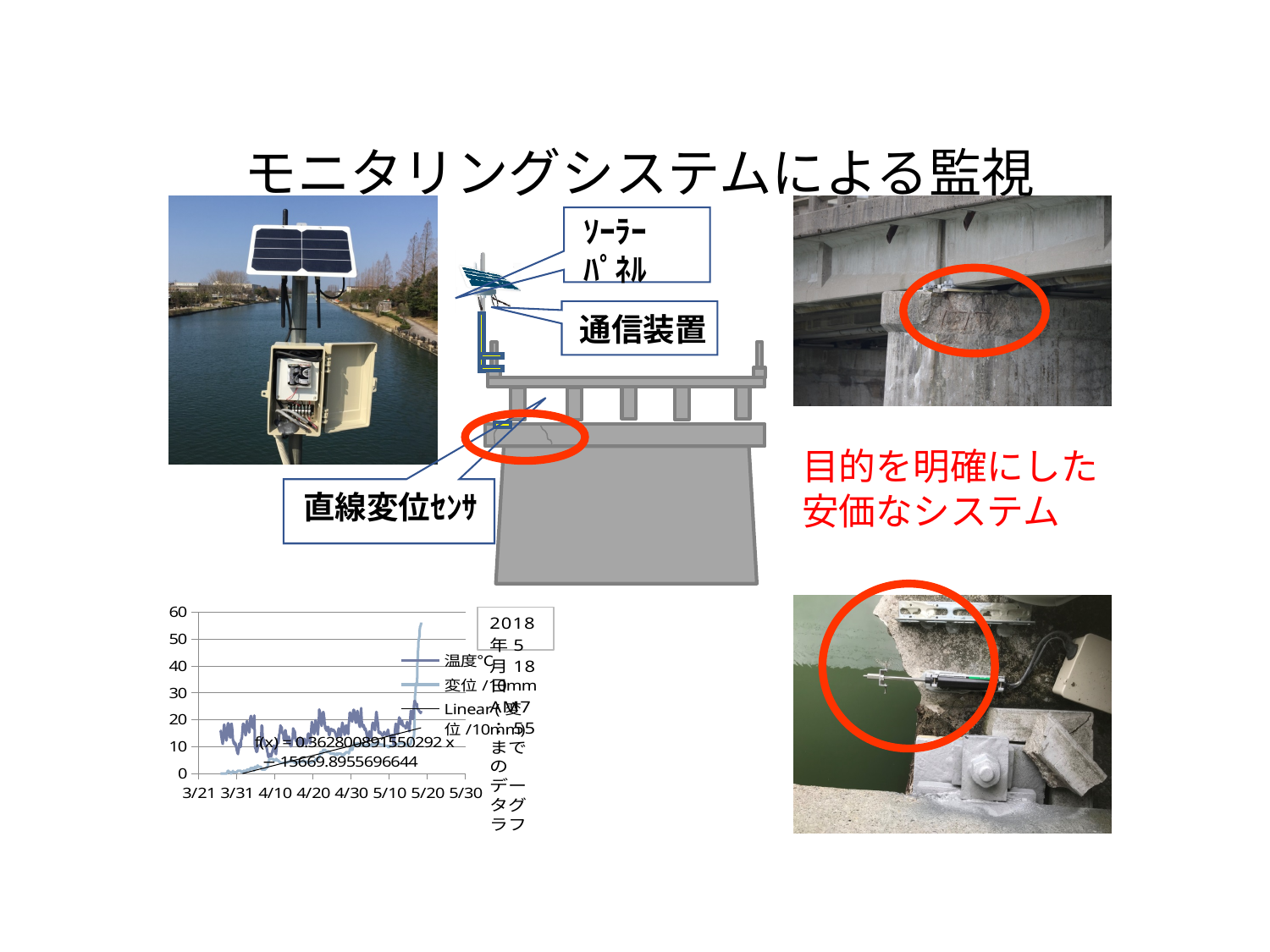
In the bottom-left chart, does the 変位 /10mm series rise or fall from 3/21 to 5/20? rise In the bottom-left chart, is the peak value of the 変位 /10mm series near 5/20 greater or less than 50? greater What is the last date label on the x axis of the bottom-left chart? 5/30 What is the second entry in the legend of the bottom-left chart? 変位 /10mm What is the slope coefficient in the trendline equation shown on the bottom-left chart? 0.362800891550292 How many date labels are shown on the x axis of the bottom-left chart? 8 How many series does the legend of the bottom-left chart list? 3 In the bottom-left chart, is the 変位 /10mm value at 3/31 greater or less than 10? less What is the first entry in the legend of the bottom-left chart? 温度°C What is the first date label on the x axis of the bottom-left chart? 3/21 What kind of chart is shown at the bottom left of the slide? line chart What is the highest value shown on the y axis of the bottom-left chart? 60